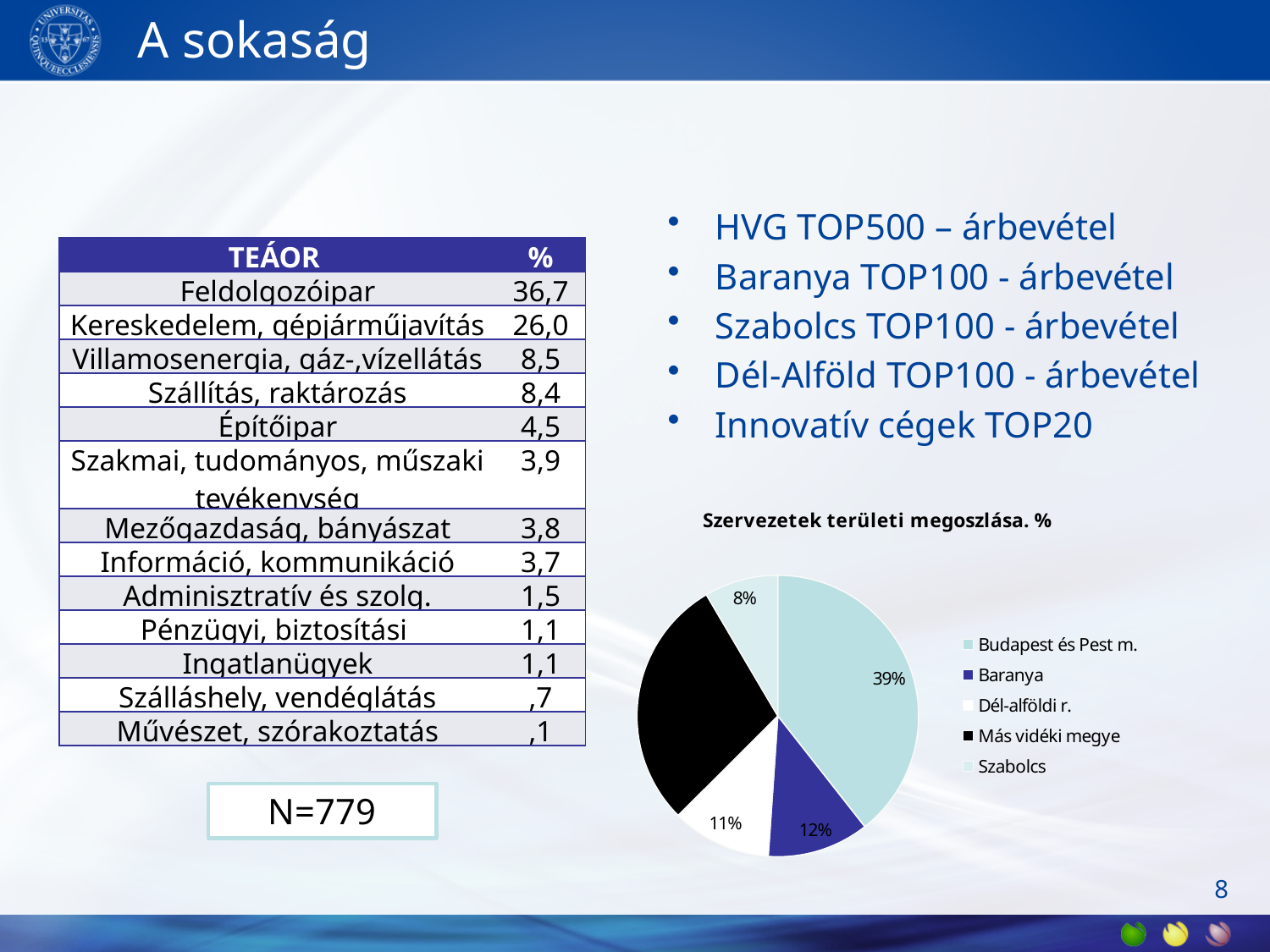
Which slice is larger, Baranya or Dél-alföldi r.? Baranya What share of the pie does Szabolcs have? 8% Which category has the smallest slice in the pie chart? Szabolcs What share of the pie does Dél-alföldi r. have? 11% What share of the pie does Budapest és Pest m. have? 39% How many slices does the pie chart have? 5 What is the title of the pie chart? Szervezetek területi megoszlása. % How many categories does the pie chart's legend list? 5 What kind of chart is shown on the slide? pie chart Which category has the largest slice in the pie chart? Budapest és Pest m. What is the difference in percentage points between the Budapest és Pest m. slice and the Baranya slice? 27